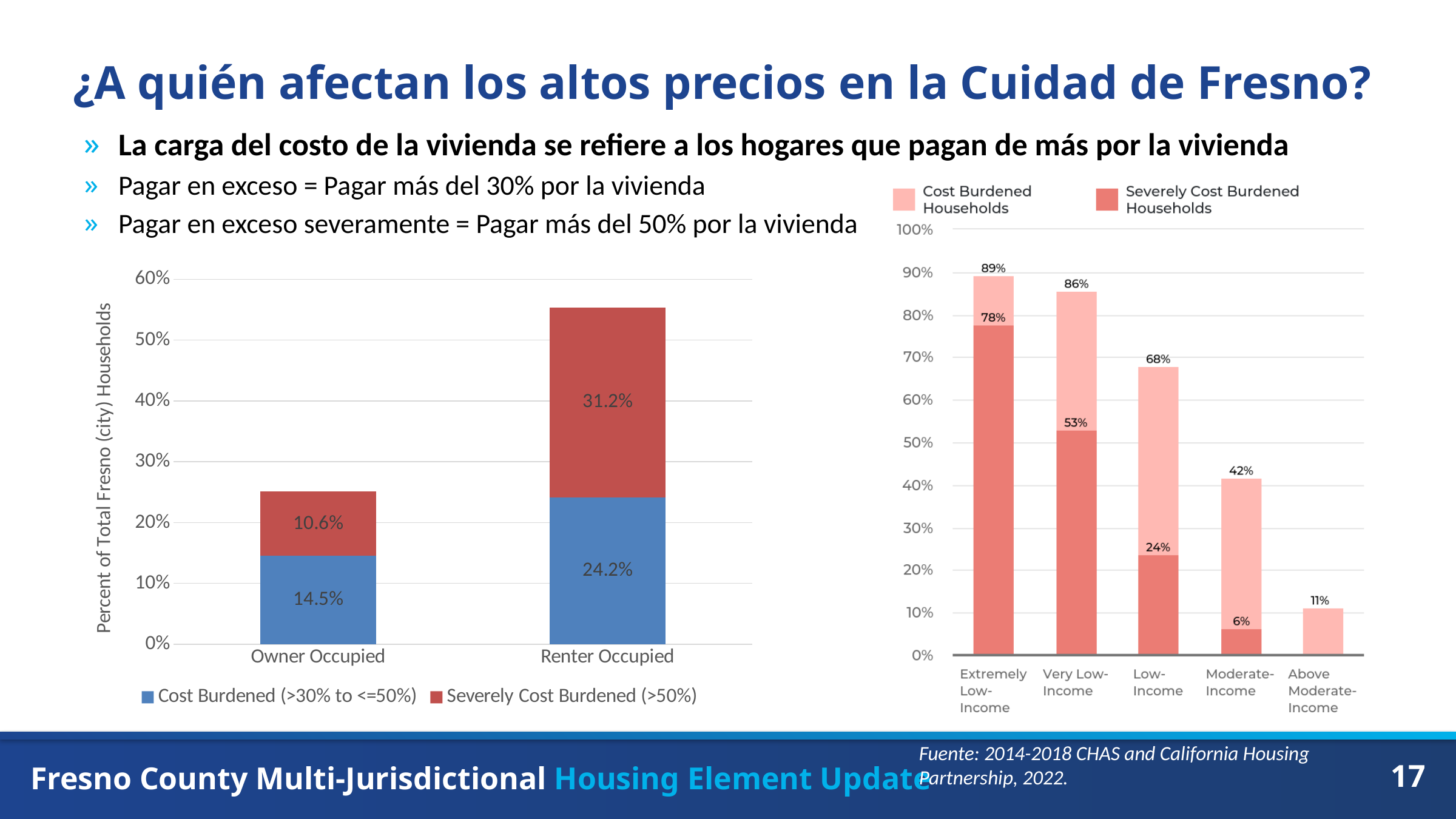
In the left chart, what is the Cost Burdened (>30% to <=50%) value for Owner Occupied households? 14.5% In the right chart, which income category has the lowest total bar? Above Moderate-Income What kind of chart is the left chart? Stacked bar chart In the left chart, what is the total height of the Renter Occupied stacked bar? 55.4% In the right chart, how many income categories are shown on the x axis? 5 In the left chart, how many series does the legend list? 2 In the left chart, what is the difference between the Severely Cost Burdened values for Renter Occupied and Owner Occupied? 20.6% In the right chart, what is the difference between the Severely Cost Burdened values for Extremely Low-Income and Very Low-Income? 25% In the left chart, which category has the larger Cost Burdened (>30% to <=50%) value, Owner Occupied or Renter Occupied? Renter Occupied In the left chart, what is the Severely Cost Burdened (>50%) value for Renter Occupied households? 31.2% In the right chart, what is the Severely Cost Burdened Households value for Low-Income? 24% In the right chart, which income category has the highest total bar? Extremely Low-Income